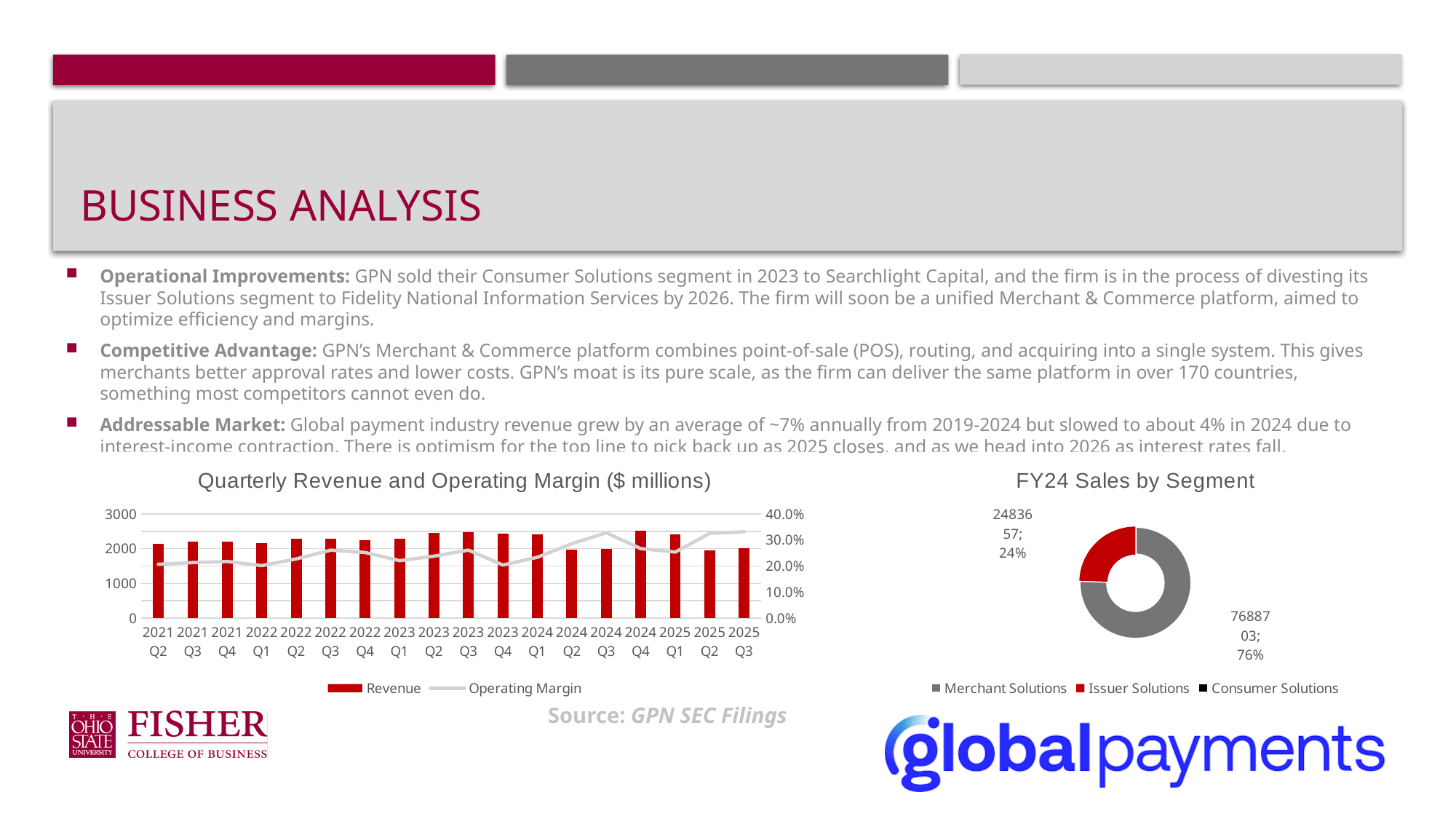
In the 'Quarterly Revenue and Operating Margin ($ millions)' chart, which series is drawn as red bars? Revenue In the 'Quarterly Revenue and Operating Margin ($ millions)' chart, is the revenue for 2024 Q4 greater or less than 2000? greater What kind of chart is the 'FY24 Sales by Segment' chart? A pie (donut) chart In the 'Quarterly Revenue and Operating Margin ($ millions)' chart, is the revenue for 2025 Q3 greater or less than 3000? less In the 'Quarterly Revenue and Operating Margin ($ millions)' chart, does the operating margin line generally rise or fall from 2021 Q2 to 2025 Q3? Rise How many quarters are plotted on the x axis of the 'Quarterly Revenue and Operating Margin ($ millions)' chart? 18 How many segments does the legend of the 'FY24 Sales by Segment' chart list? 3 In the 'Quarterly Revenue and Operating Margin ($ millions)' chart, is the operating margin for 2025 Q3 greater or less than 20.0%? greater How many series does the legend of the 'Quarterly Revenue and Operating Margin ($ millions)' chart list? 2 In the 'FY24 Sales by Segment' chart, what share of sales does Merchant Solutions account for? 76% In the 'FY24 Sales by Segment' chart, which segment is larger, Merchant Solutions or Issuer Solutions? Merchant Solutions What kind of chart is the 'Quarterly Revenue and Operating Margin ($ millions)' chart? A bar chart combined with a line chart